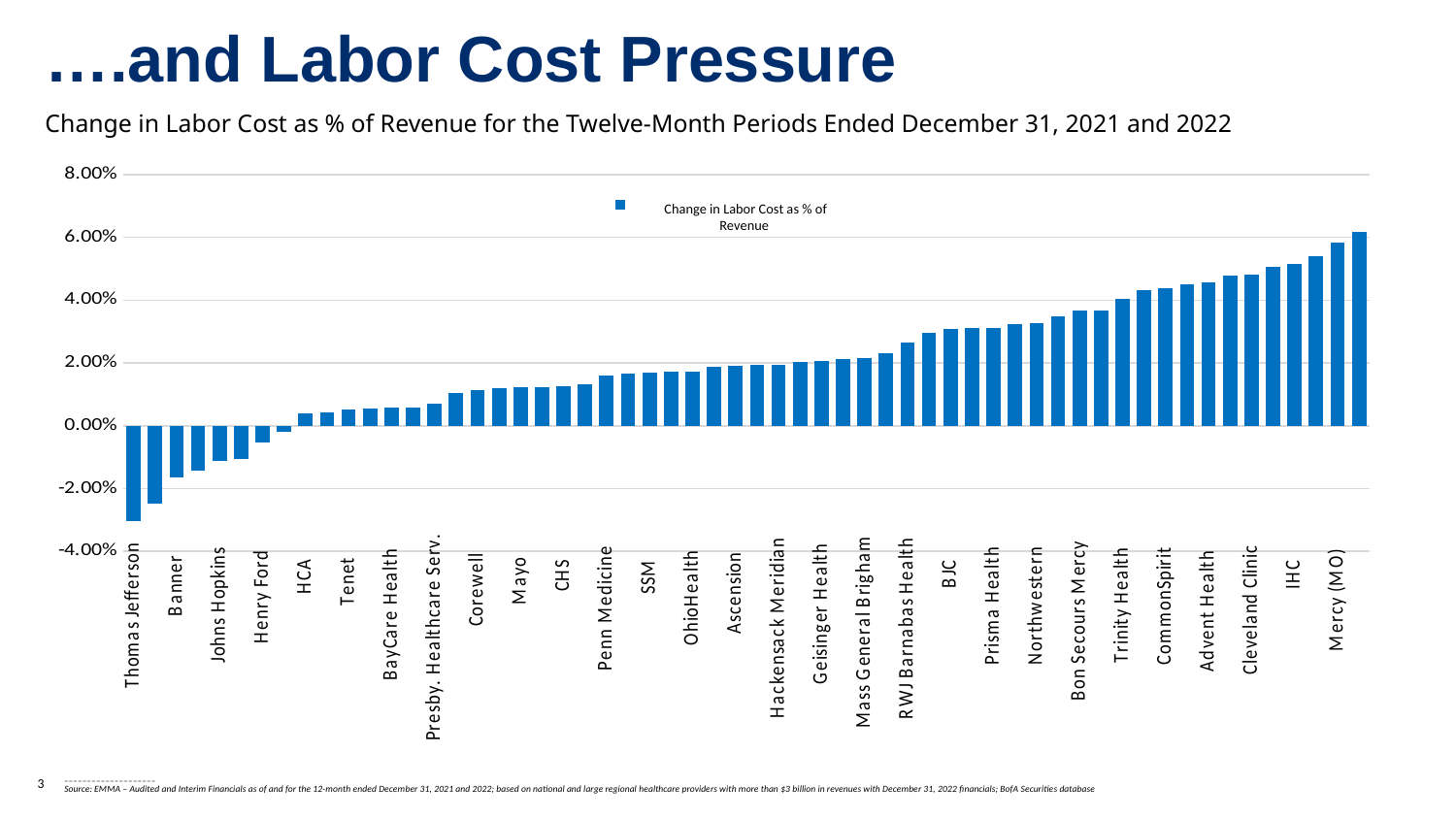
How many series does the legend list? 1 Is the value for Thomas Jefferson greater or less than -2.00%? less What is the legend entry shown on the chart? Change in Labor Cost as % of Revenue Is the value for IHC greater or less than 4.00%? greater Is the value for Johns Hopkins greater or less than -2.00%? greater What kind of chart is shown on the slide? Bar chart Which organization has the lowest change in labor cost as % of revenue? Thomas Jefferson Which has the larger change in labor cost as % of revenue, Banner or Johns Hopkins? Johns Hopkins Do the values rise or fall moving from left to right along the x axis? Rise